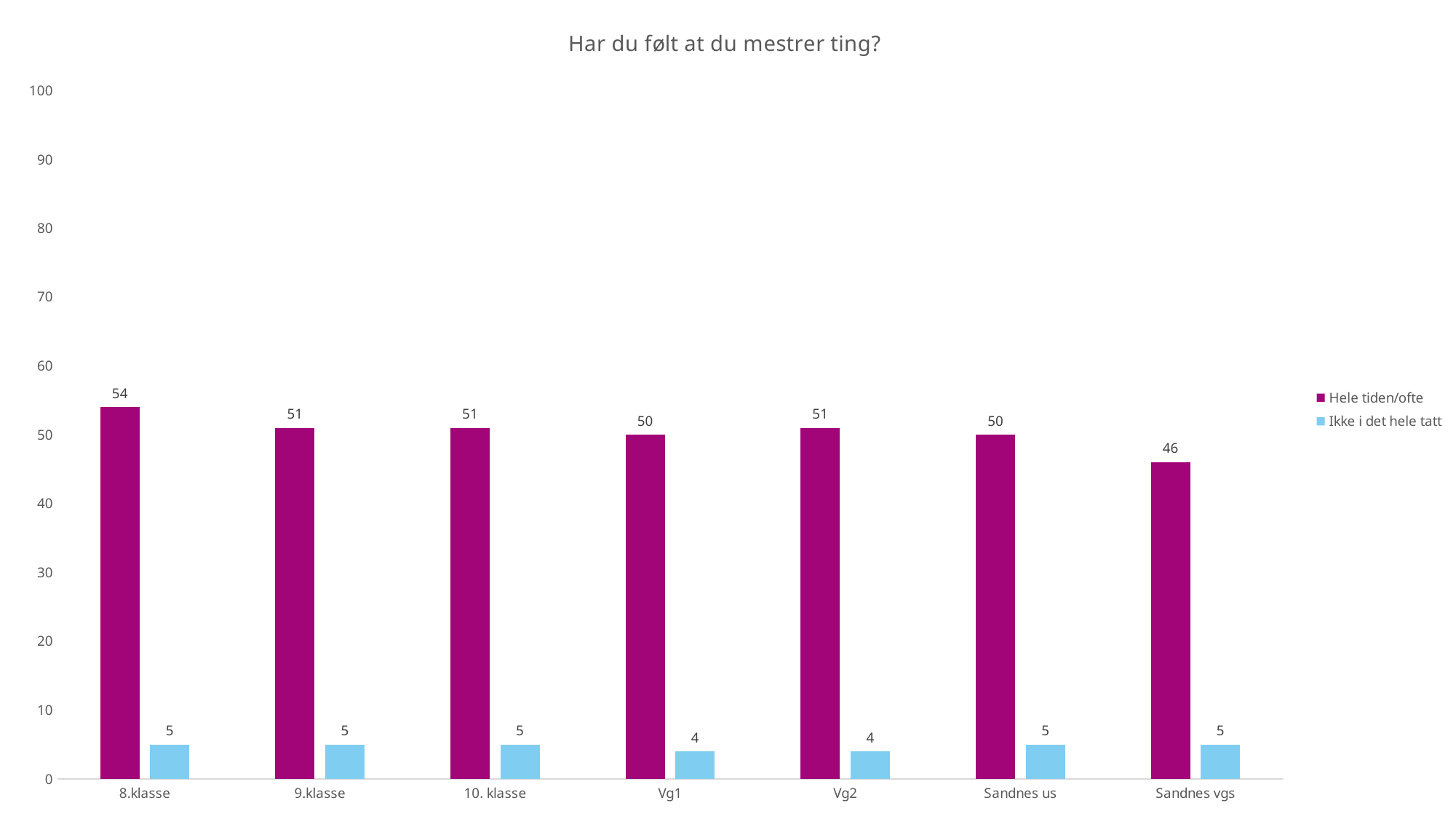
What is the value for 'Ikke i det hele tatt' for Vg1? 4 What is the value for 'Hele tiden/ofte' for Sandnes vgs? 46 Is the value for 'Hele tiden/ofte' for Vg2 greater or less than 40? greater What is the value for 'Hele tiden/ofte' for 8.klasse? 54 What is the difference between the 'Hele tiden/ofte' values for 8.klasse and Sandnes vgs? 8 How many series does the legend list? 2 Which category has the lowest value for 'Hele tiden/ofte'? Sandnes vgs Which category has the highest value for 'Hele tiden/ofte'? 8.klasse Which is larger: the 'Hele tiden/ofte' value for 9.klasse or for Sandnes vgs? 9.klasse How many categories are shown on the x axis? 7 What kind of chart is shown on the slide? Bar chart What is the title of the chart? Har du følt at du mestrer ting?